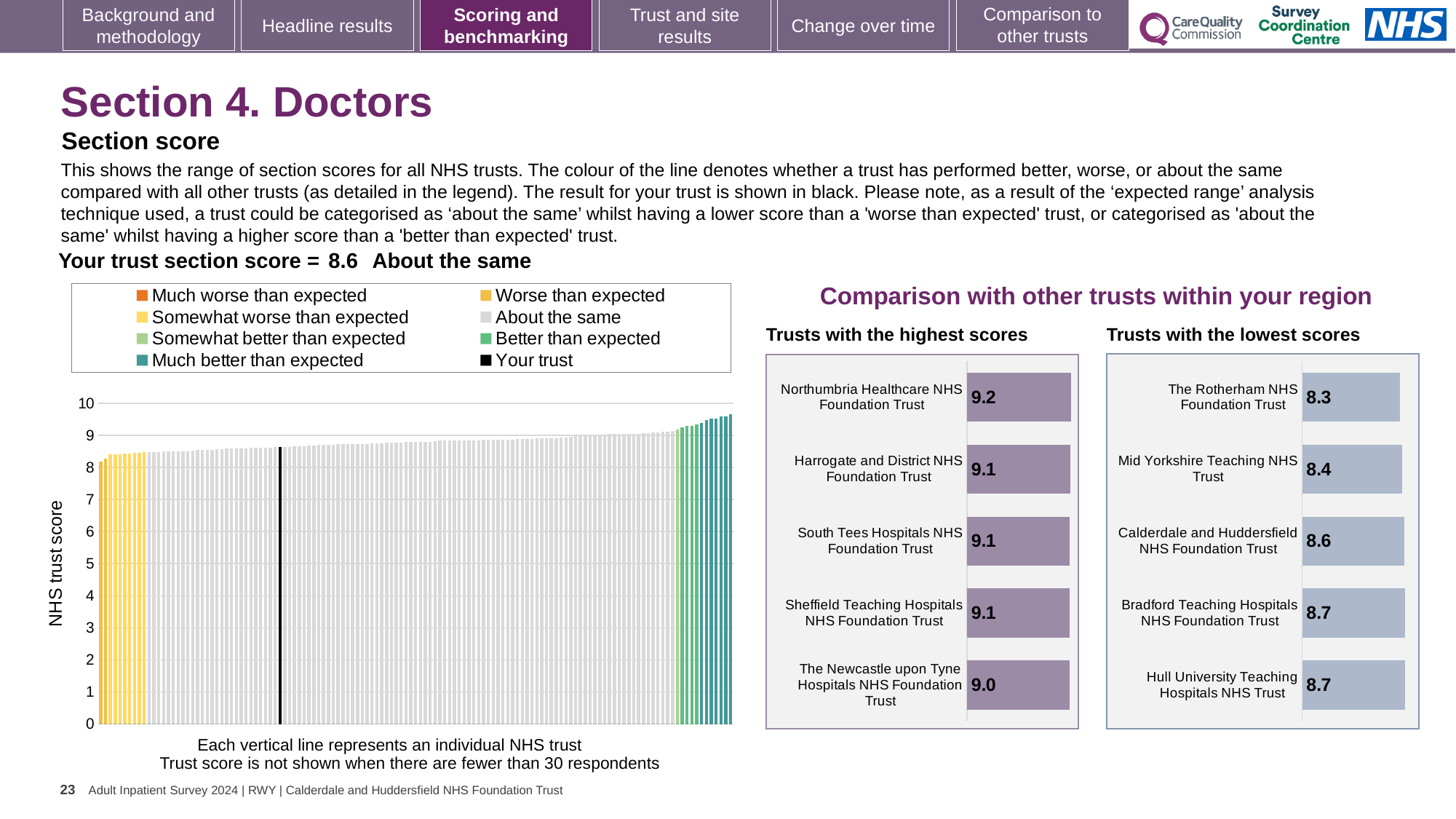
In the 'Trusts with the highest scores' chart, which trust has the highest score? Northumbria Healthcare NHS Foundation Trust In the NHS trust score chart on the left, do the values rise or fall from left to right? Rise In the 'Trusts with the highest scores' chart, what is the score for Northumbria Healthcare NHS Foundation Trust? 9.2 How many trusts are listed in the 'Trusts with the highest scores' chart? 5 How many entries does the legend of the NHS trust score chart on the left list? 8 What kind of chart is the NHS trust score chart on the left of the slide? Bar chart In the 'Trusts with the highest scores' chart, what is the difference between the scores of Northumbria Healthcare NHS Foundation Trust and The Newcastle upon Tyne Hospitals NHS Foundation Trust? 0.2 In the 'Trusts with the lowest scores' chart, which trust has the lowest score? The Rotherham NHS Foundation Trust Which has a higher score: Mid Yorkshire Teaching NHS Trust in the 'Trusts with the lowest scores' chart or Harrogate and District NHS Foundation Trust in the 'Trusts with the highest scores' chart? Harrogate and District NHS Foundation Trust In the 'Trusts with the lowest scores' chart, what is the score for Calderdale and Huddersfield NHS Foundation Trust? 8.6 In the 'Trusts with the lowest scores' chart, what is the score for The Rotherham NHS Foundation Trust? 8.3 In the 'Trusts with the lowest scores' chart, what is the difference between the scores of Hull University Teaching Hospitals NHS Trust and The Rotherham NHS Foundation Trust? 0.4